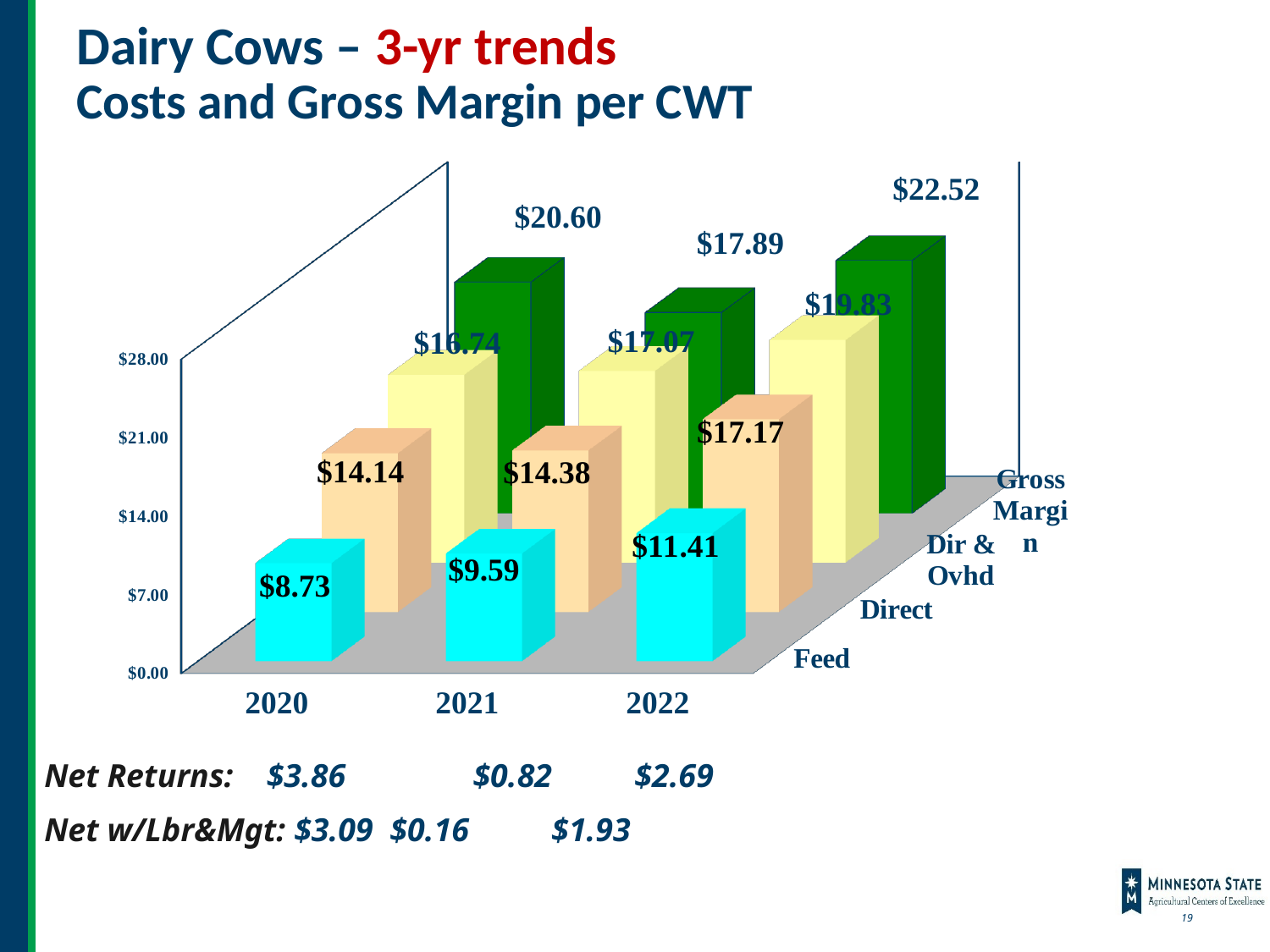
In which year is the Feed cost highest? 2022 Does the Feed cost rise or fall from 2020 to 2022? rises What kind of chart is shown on the slide? bar chart What is the Gross Margin per CWT for 2022? $22.52 How much higher is the Feed cost in 2022 than in 2020? $2.68 How many years are shown on the x axis of the chart? 3 What is the Dir & Ovhd value for 2022? $19.83 What is the difference between the Direct cost in 2022 and in 2021? $2.79 Which year has the larger Gross Margin, 2020 or 2021? 2020 What is the Feed cost per CWT for 2020? $8.73 What is the Direct cost per CWT for 2022? $17.17 In which year is the Gross Margin lowest? 2021